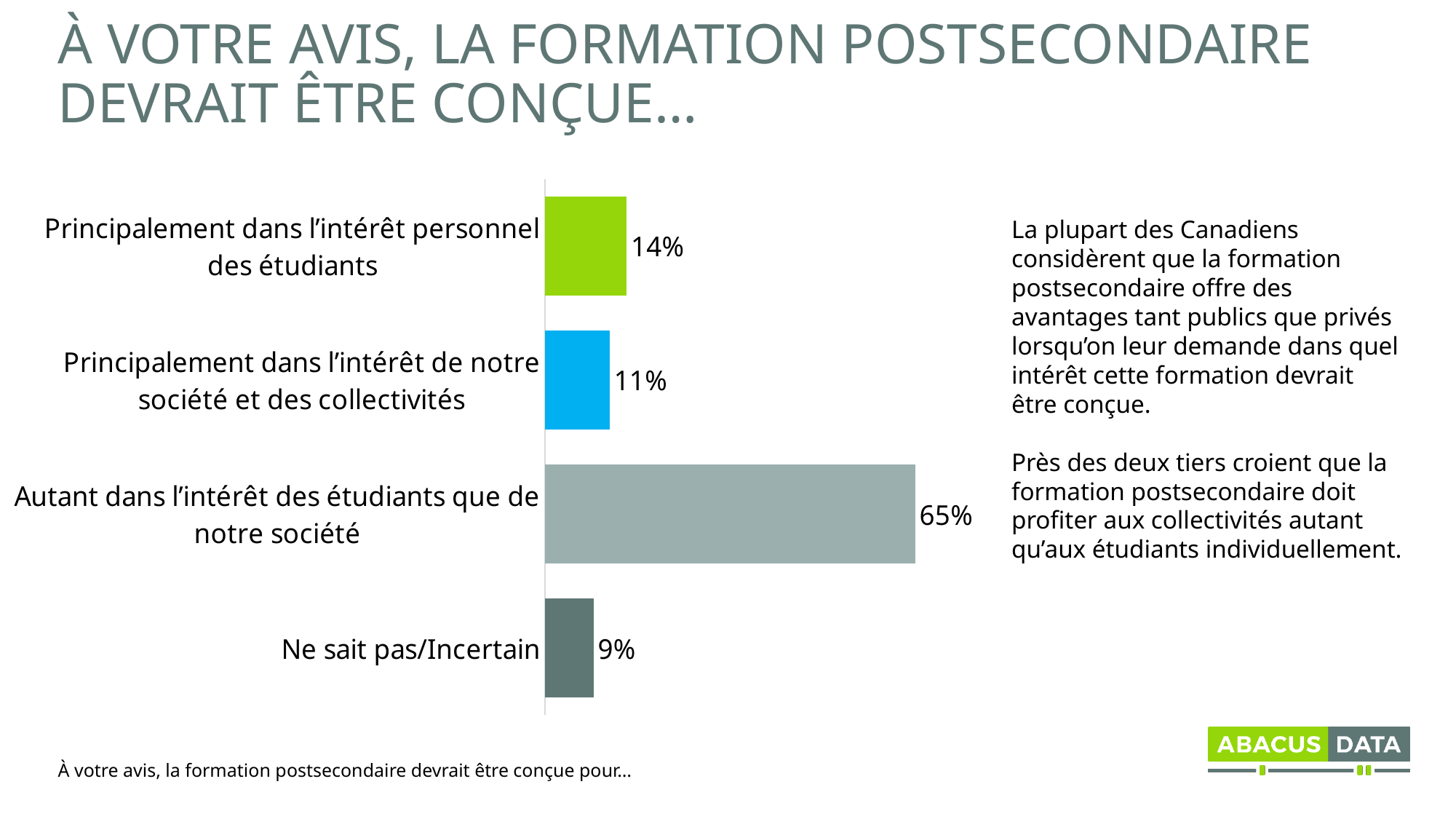
What is the value for "Principalement dans l'intérêt personnel des étudiants"? 14% Which category has the lowest value? Ne sait pas/Incertain What colour is the bar for "Principalement dans l'intérêt de notre société et des collectivités"? Blue Which category has the highest value? Autant dans l'intérêt des étudiants que de notre société What kind of chart is shown on the slide? Bar chart What is the difference between the values for "Principalement dans l'intérêt personnel des étudiants" and "Principalement dans l'intérêt de notre société et des collectivités"? 3% What percentage of respondents answered "Ne sait pas/Incertain"? 9% What percentage of respondents chose "Autant dans l'intérêt des étudiants que de notre société"? 65% How many categories are shown in the chart? 4 What is the difference between the value for "Autant dans l'intérêt des étudiants que de notre société" and the value for "Principalement dans l'intérêt personnel des étudiants"? 51% What is the value for "Principalement dans l'intérêt de notre société et des collectivités"? 11% Which is larger: the value for "Principalement dans l'intérêt personnel des étudiants" or the value for "Ne sait pas/Incertain"? Principalement dans l'intérêt personnel des étudiants